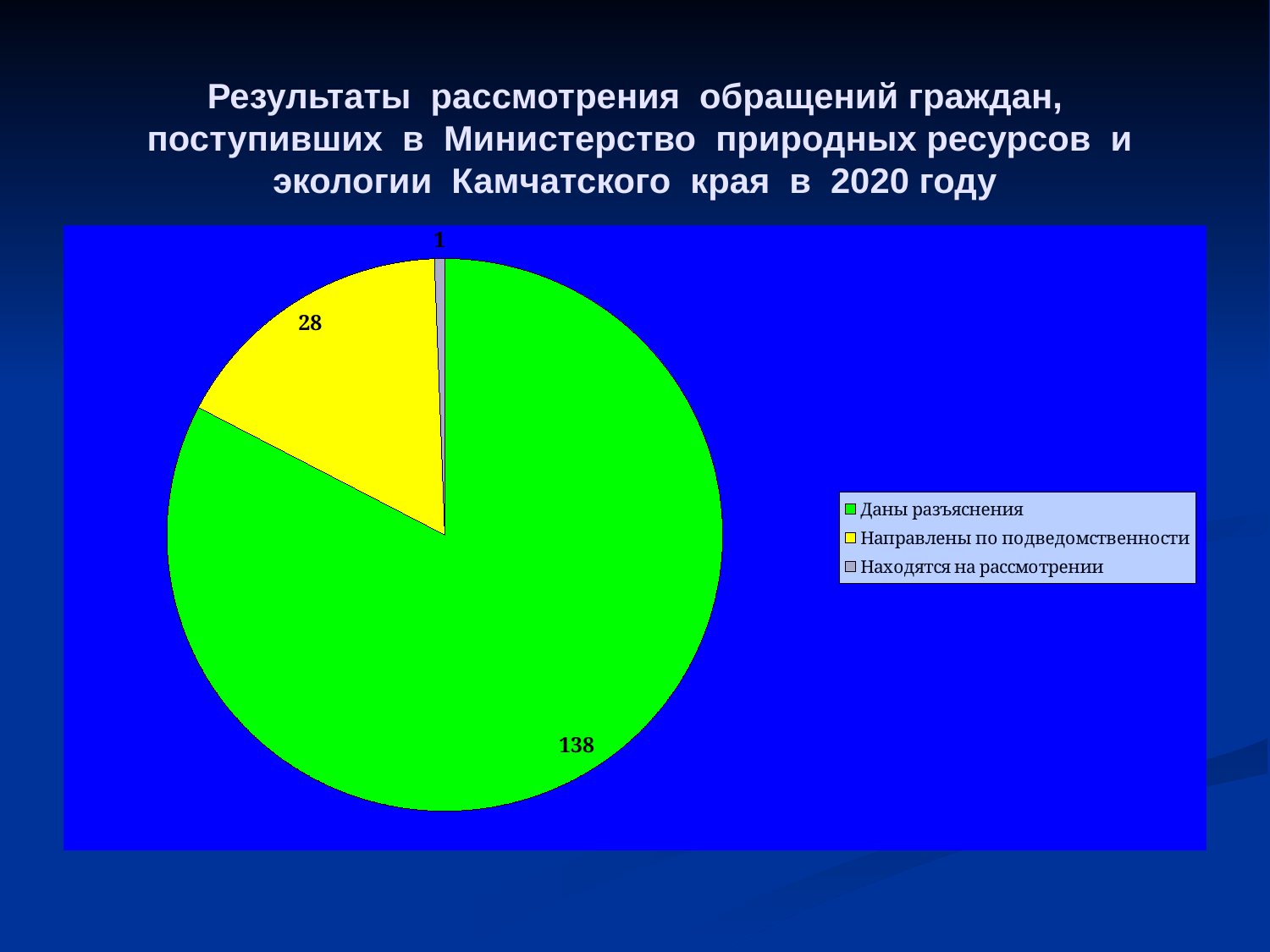
What is the difference between the values for "Даны разъяснения" and "Направлены по подведомственности"? 110 How many slices does the pie chart have? 3 What colour is the slice for "Направлены по подведомственности"? Yellow Which is larger: the value for "Направлены по подведомственности" or the value for "Находятся на рассмотрении"? Направлены по подведомственности What is the value for "Направлены по подведомственности"? 28 What is the value for "Даны разъяснения"? 138 What is the total of all the values in the pie chart? 167 Which category has the smallest slice of the pie? Находятся на рассмотрении Which category has the largest slice of the pie? Даны разъяснения What is the value for "Находятся на рассмотрении"? 1 What kind of chart is shown on the slide? Pie chart How many entries does the legend list? 3